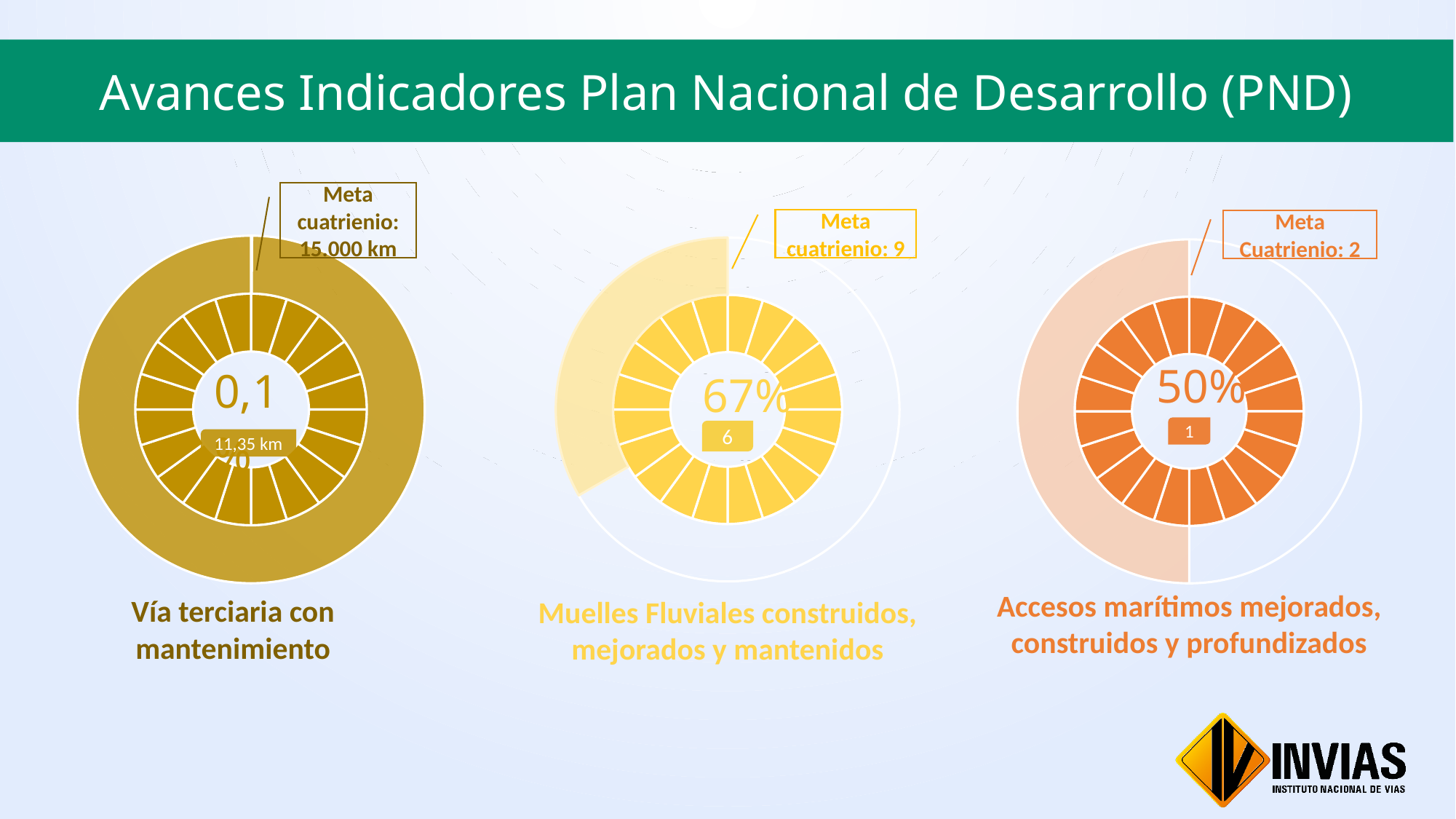
What is the title of the slide containing the charts? Avances Indicadores Plan Nacional de Desarrollo (PND) In the 'Muelles Fluviales construidos, mejorados y mantenidos' chart, what percentage of progress is shown in the centre? 67% What kind of chart is used for the 'Muelles Fluviales construidos, mejorados y mantenidos' indicator? Donut (ring) chart In the 'Accesos marítimos mejorados, construidos y profundizados' chart, what percentage of progress is shown in the centre? 50% In the 'Vía terciaria con mantenimiento' chart, how many km are reported as achieved? 11,35 km Which indicator shows a higher percentage of progress: 'Muelles Fluviales construidos, mejorados y mantenidos' or 'Accesos marítimos mejorados, construidos y profundizados'? Muelles Fluviales construidos, mejorados y mantenidos How many gauge charts are shown on the slide? 3 In the 'Muelles Fluviales construidos, mejorados y mantenidos' chart, how many more muelles are needed to reach the 'Meta cuatrienio' of 9, given 6 achieved? 3 In the 'Vía terciaria con mantenimiento' chart, what value is shown in the centre? 0,1 What is the 'Meta cuatrienio' for the 'Vía terciaria con mantenimiento' chart? 15.000 km What is the 'Meta Cuatrienio' for the 'Accesos marítimos mejorados, construidos y profundizados' chart? 2 What is the 'Meta cuatrienio' for the 'Muelles Fluviales construidos, mejorados y mantenidos' chart? 9